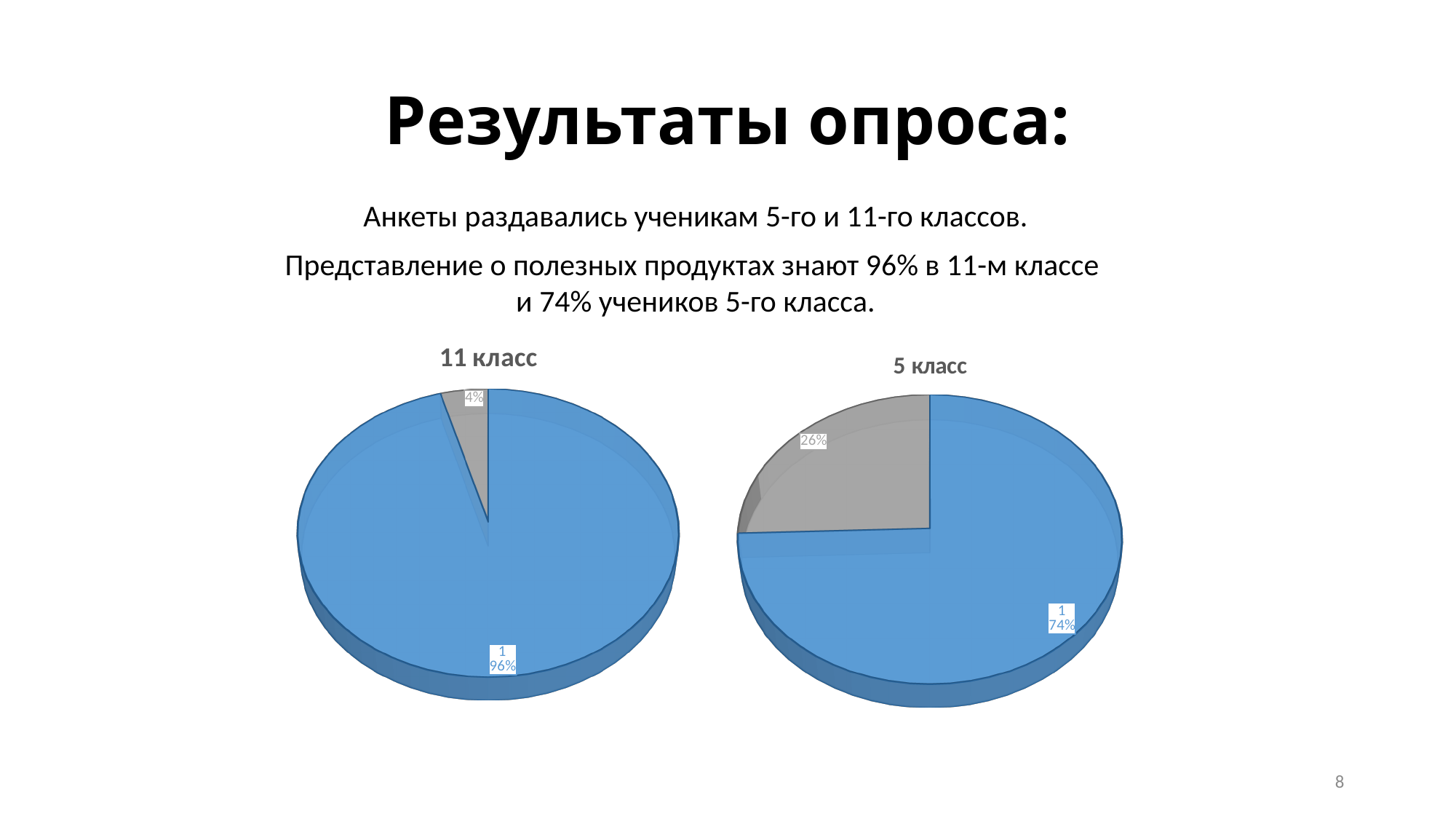
What kind of chart is the "5 класс" chart? pie chart How many slices does the "11 класс" pie chart have? 2 In the "5 класс" pie chart, what share does the blue slice labelled "1" have? 74% What kind of chart is the "11 класс" chart? pie chart In the "11 класс" pie chart, what share does the grey slice have? 4% In the "5 класс" pie chart, which slice is larger, the blue one or the grey one? the blue one In the "5 класс" pie chart, what share does the grey slice have? 26% What is the title of the pie chart on the left of the slide? 11 класс How many slices does the "5 класс" pie chart have? 2 What is the difference between the blue slice in the "11 класс" chart and the blue slice in the "5 класс" chart? 22% In the "5 класс" pie chart, what is the difference between the blue slice and the grey slice? 48%